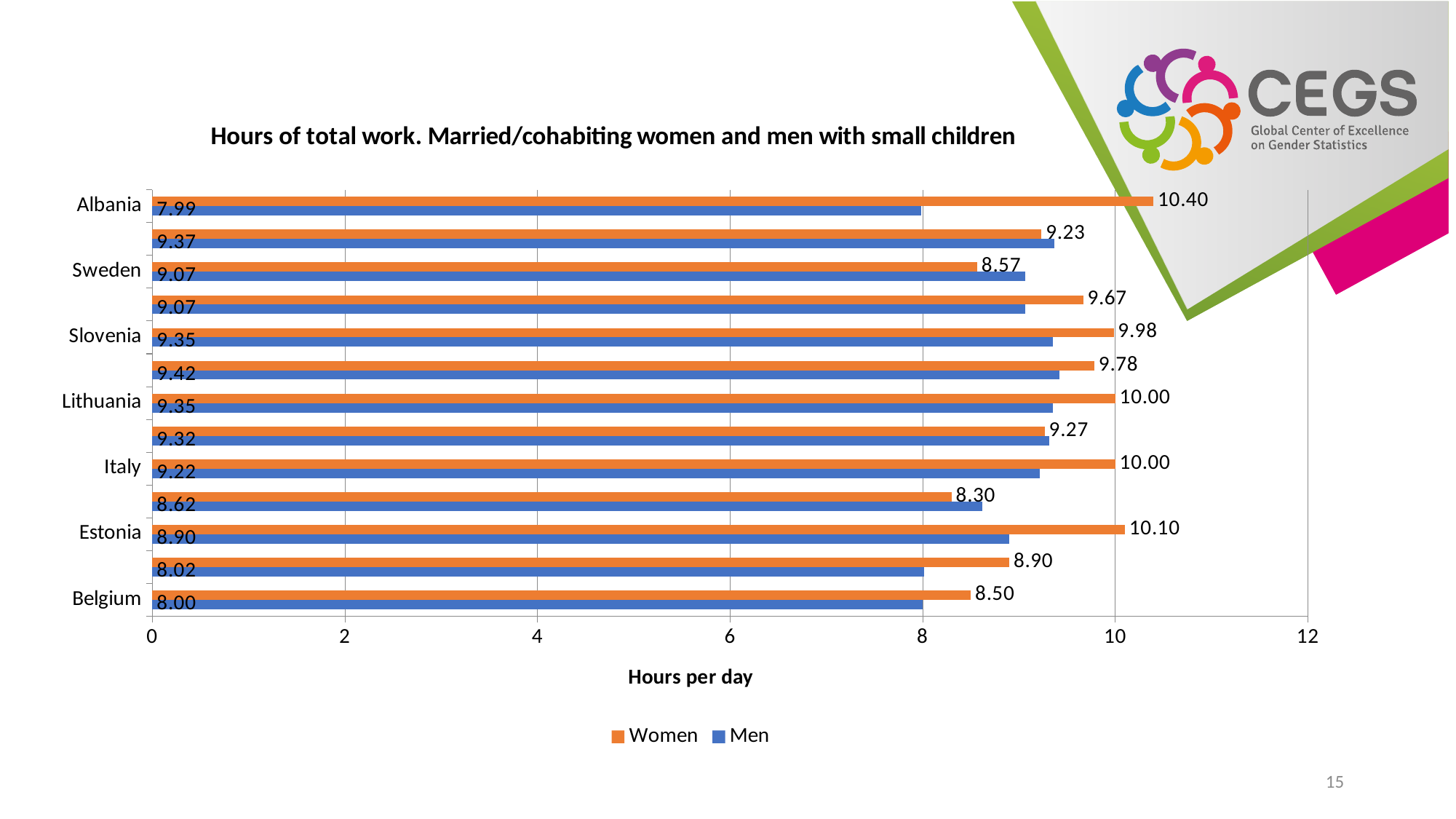
How many series does the legend list? 2 In Sweden, which is larger, the value for Women or the value for Men? Men What is the value for Men in Belgium? 8.00 What is the value for Women in Albania? 10.40 What is the difference between the Men and Women values for Sweden? 0.50 What is the value for Men in Sweden? 9.07 What is the difference between the Women and Men values for Albania? 2.41 What is the value for Women in Estonia? 10.10 Which labelled country has the lowest value for Men? Albania Is the value for Women in Belgium greater or less than 10? less What kind of chart is shown on the slide? Bar chart Which labelled country has the highest value for Women? Albania